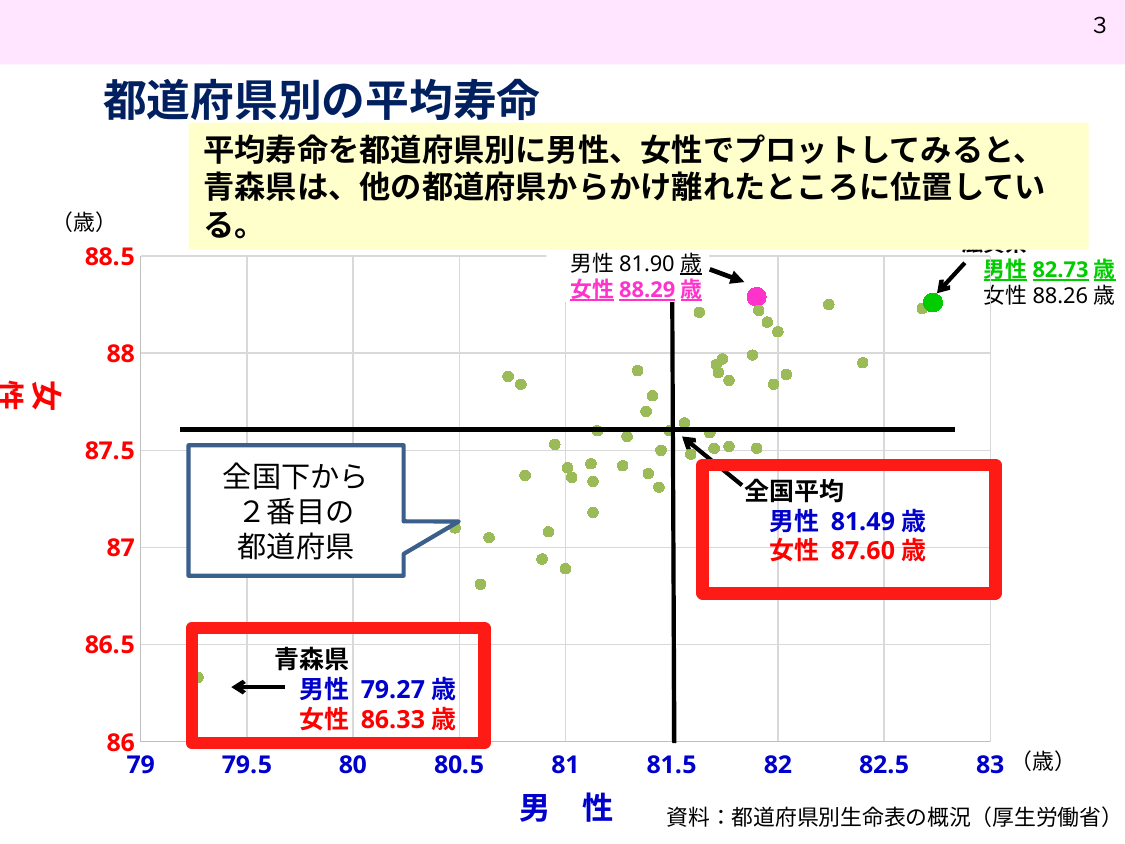
How much lower is the female life expectancy of 青森県 than the national average female life expectancy? 1.27歳 What is the national average (全国平均) female life expectancy shown on the chart? 87.60歳 What is the female life expectancy of the pink (magenta) point on the chart? 88.29歳 What kind of chart is shown on the slide? scatter plot What is the female life expectancy for 青森県 shown on the chart? 86.33歳 How much lower is the male life expectancy of 青森県 than the national average male life expectancy? 2.22歳 What is the male life expectancy for 青森県 shown on the chart? 79.27歳 What is the male life expectancy of the green point on the chart? 82.73歳 Which has the higher male life expectancy: the pink point (81.90歳) or the green point (82.73歳)? the green point What is the title of the chart on the slide? 都道府県別の平均寿命 Which prefecture has the lowest female life expectancy on the chart? 青森県 What is the national average (全国平均) male life expectancy shown on the chart? 81.49歳